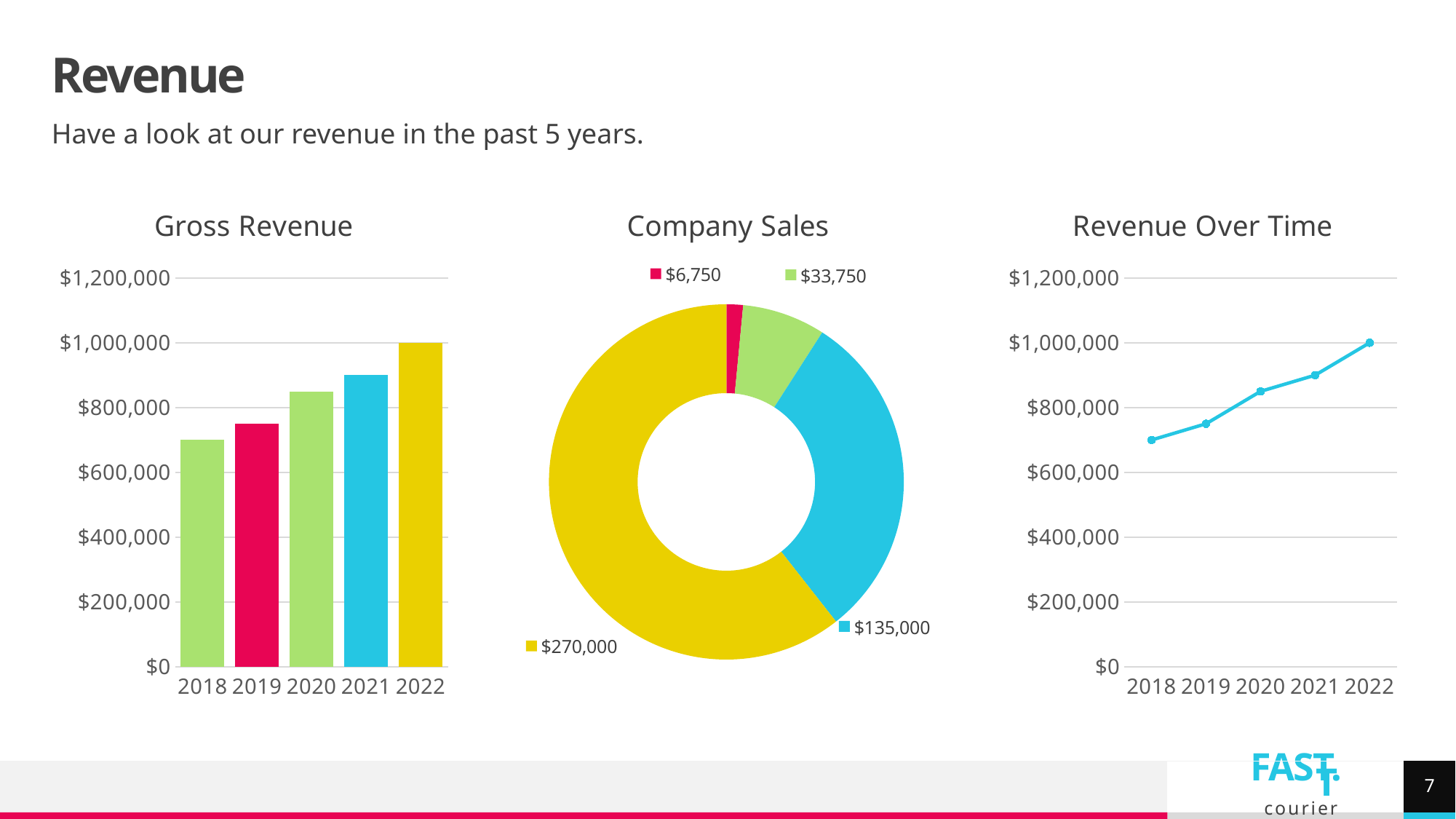
In the Company Sales chart, how many slices does the doughnut have? 4 In the Revenue Over Time chart, do the values rise or fall from 2018 to 2022? rise In the Gross Revenue chart, how many years are shown on the x axis? 5 In the Gross Revenue chart, is the value for 2018 greater or less than $800,000? less In the Company Sales chart, what is the smallest value shown? $6,750 What kind of chart is the Gross Revenue chart? bar chart In the Gross Revenue chart, which year has the lowest gross revenue? 2018 In the Gross Revenue chart, is the value for 2020 greater or less than $800,000? greater In the Gross Revenue chart, which year has the highest gross revenue? 2022 In the Company Sales chart, what is the largest value shown? $270,000 In the Gross Revenue chart, what is the value for 2022? $1,000,000 In the Company Sales chart, what is the difference between the largest slice ($270,000) and the blue slice ($135,000)? $135,000